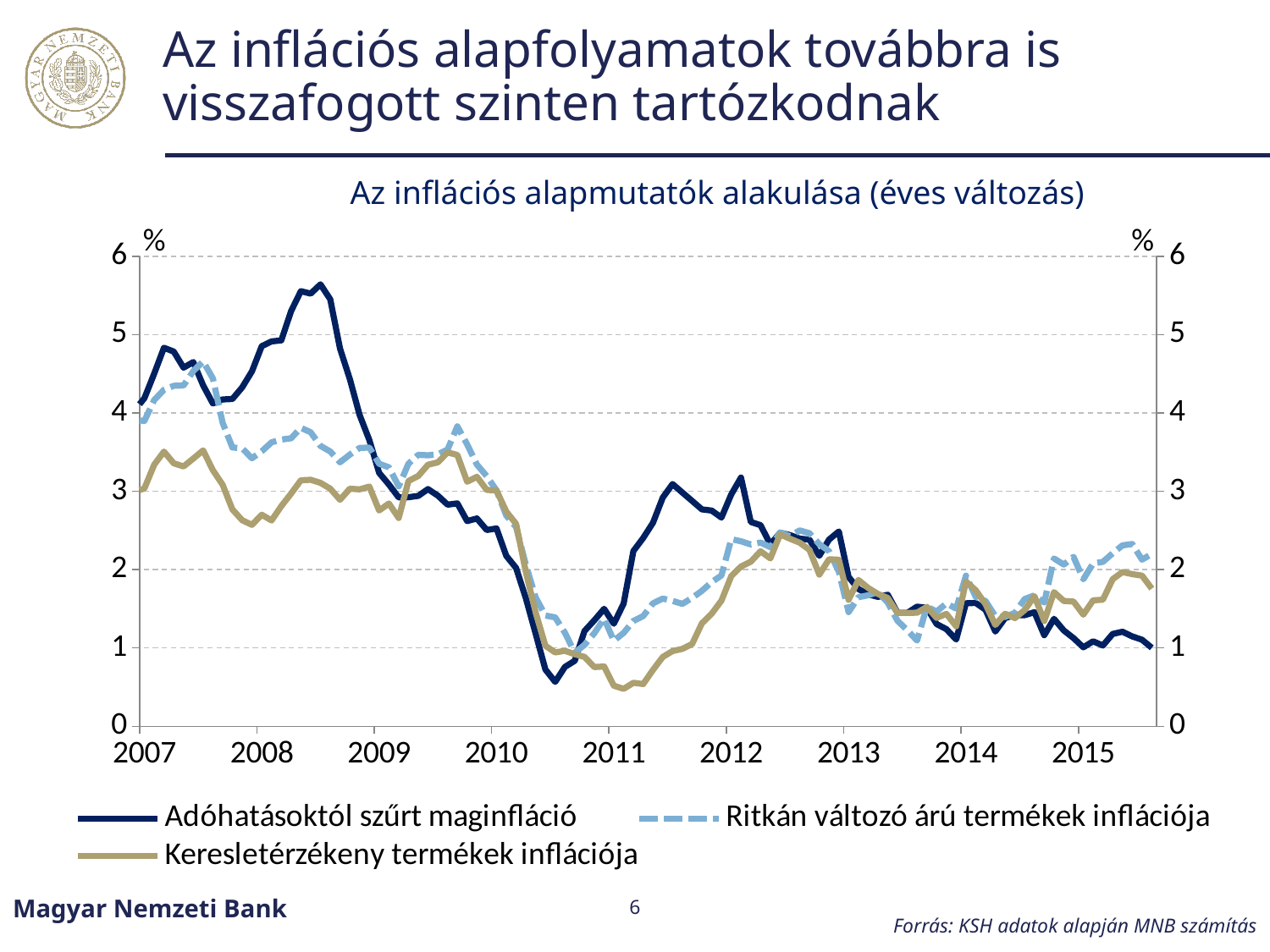
What is the title of the chart? Az inflációs alapmutatók alakulása (éves változás) Is the value of Adóhatásoktól szűrt maginfláció at the end of 2015 greater or less than 2? less Does Adóhatásoktól szűrt maginfláció generally rise or fall from 2012 to 2015? fall Is the value of Keresletérzékeny termékek inflációja at the start of 2011 greater or less than 1? less What kind of chart is shown on the slide? line chart At the start of 2008, which is higher: Adóhatásoktól szűrt maginfláció or Keresletérzékeny termékek inflációja? Adóhatásoktól szűrt maginfláció Is the peak value of Adóhatásoktól szűrt maginfláció in 2008 greater or less than 5? greater How many series does the legend list? 3 Which series is drawn with a dashed line? Ritkán változó árú termékek inflációja How many year labels are shown on the x axis? 9 Which series reaches the highest value anywhere on the chart? Adóhatásoktól szűrt maginfláció